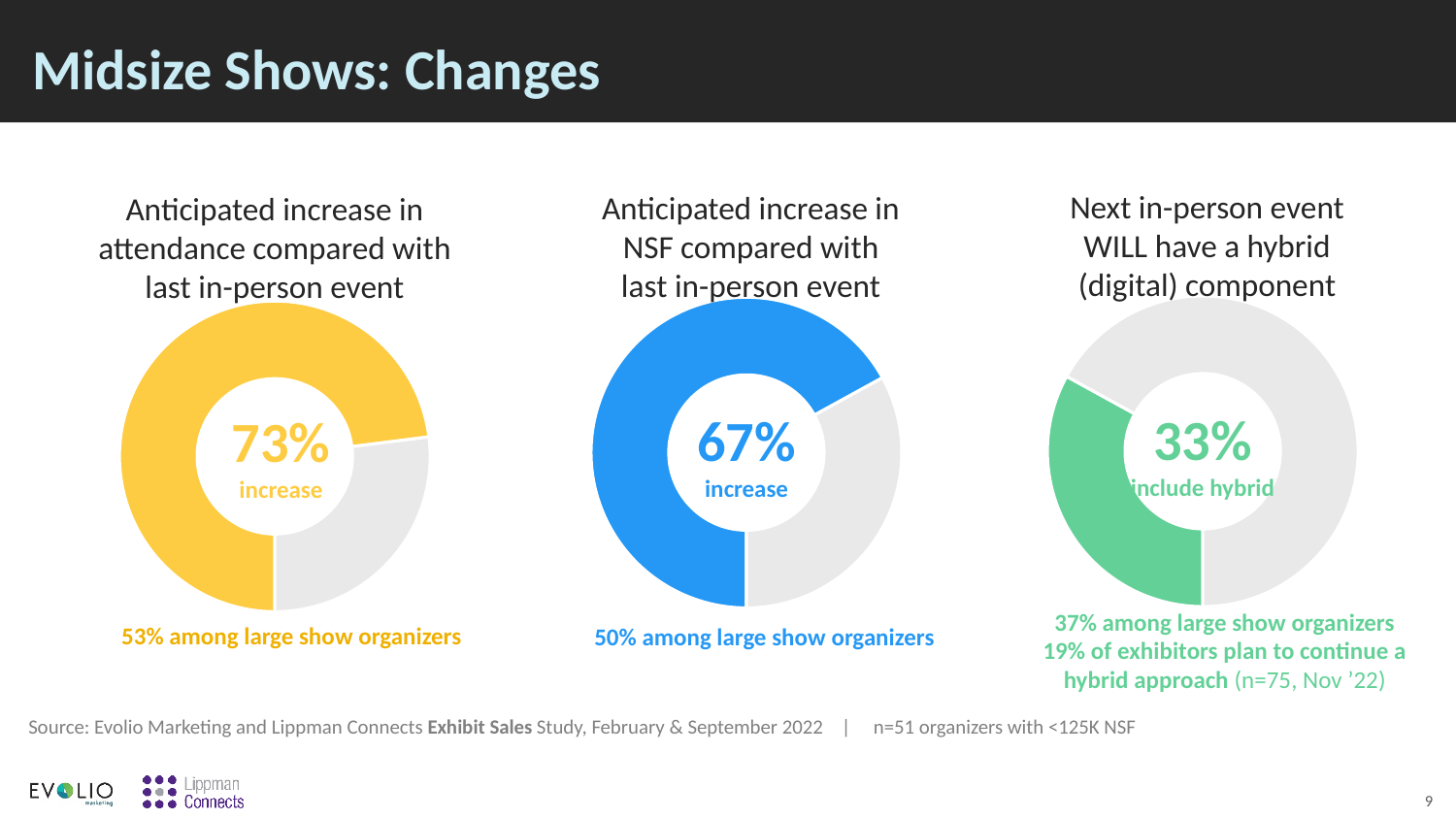
Is the percentage anticipating an NSF increase larger or smaller than the percentage anticipating an attendance increase? Smaller What kind of chart is used to show the anticipated increase in attendance? Donut (pie) chart According to the note under the left chart, what percentage of large show organizers anticipate an attendance increase? 53% In the right chart, what percentage say their next in-person event will have a hybrid (digital) component? 33% What colour is the highlighted segment in the chart about hybrid components? Green Which of the three charts shows the highest highlighted percentage? Anticipated increase in attendance (73%) How many donut charts are shown on the slide? 3 In the left chart, what percentage of midsize show organizers anticipate an increase in attendance compared with their last in-person event? 73% In the right chart, what share of the donut is not highlighted (does not include hybrid)? 67% What is the difference between the anticipated attendance increase percentage and the anticipated NSF increase percentage? 6 percentage points Which of the three charts shows the lowest highlighted percentage? Next in-person event WILL have a hybrid component (33%) In the middle chart, what percentage anticipate an increase in NSF compared with their last in-person event? 67%